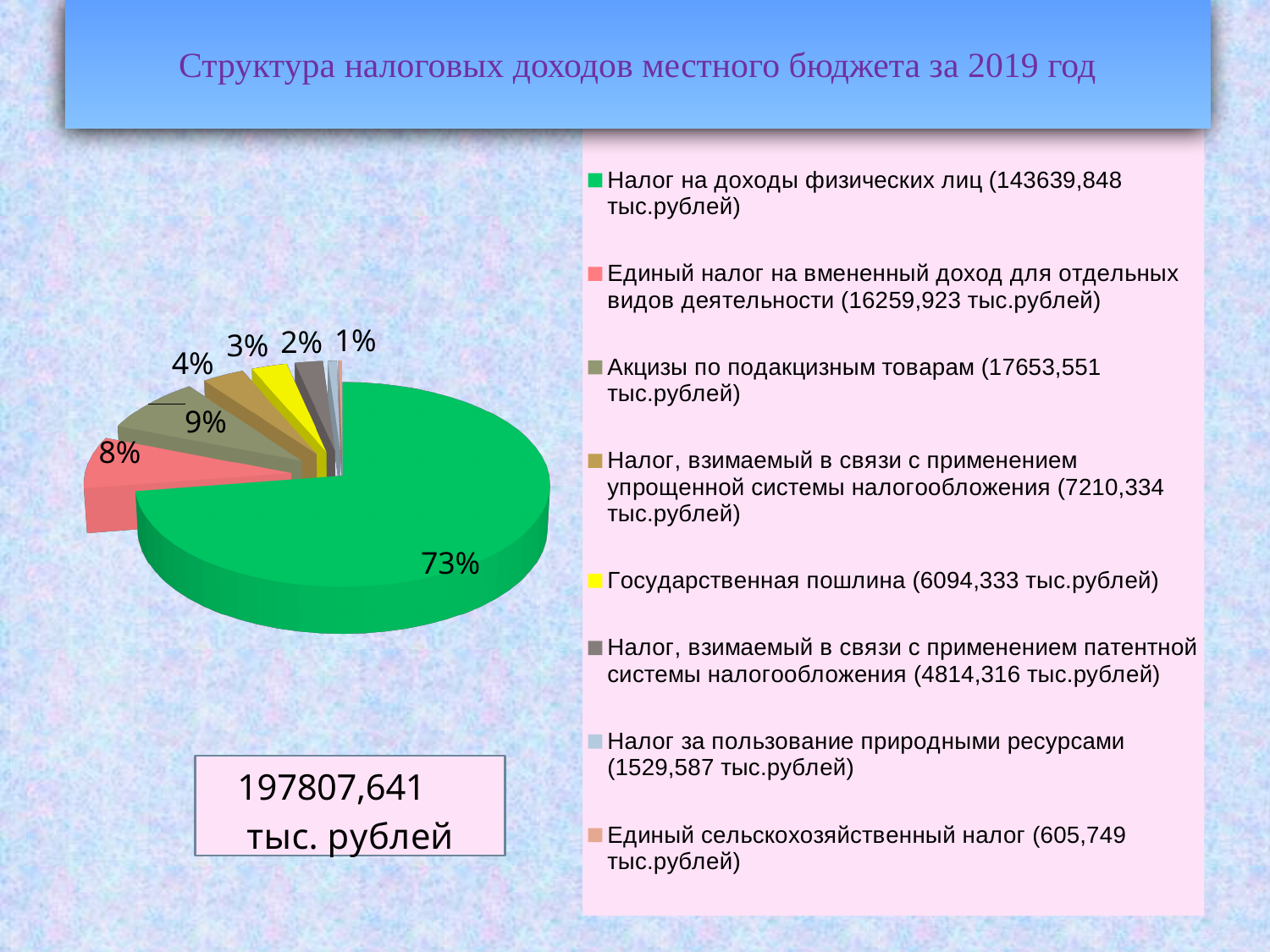
How many categories does the legend list? 8 What amount is given in the legend for 'Единый сельскохозяйственный налог'? 605,749 тыс.рублей What share of the pie does 'Акцизы по подакцизным товарам' take? 9% What kind of chart is shown on the slide? pie chart What share of the pie does 'Налог на доходы физических лиц' take? 73% Which is larger: the amount for 'Акцизы по подакцизным товарам' or for 'Единый налог на вмененный доход для отдельных видов деятельности'? Акцизы по подакцизным товарам What amount is given in the legend for 'Государственная пошлина'? 6094,333 тыс.рублей What total amount is shown in the box below the pie chart? 197807,641 тыс. рублей What amount is given in the legend for 'Налог за пользование природными ресурсами'? 1529,587 тыс.рублей Which category has the largest slice of the pie? Налог на доходы физических лиц What share of the pie does 'Государственная пошлина' take? 3%